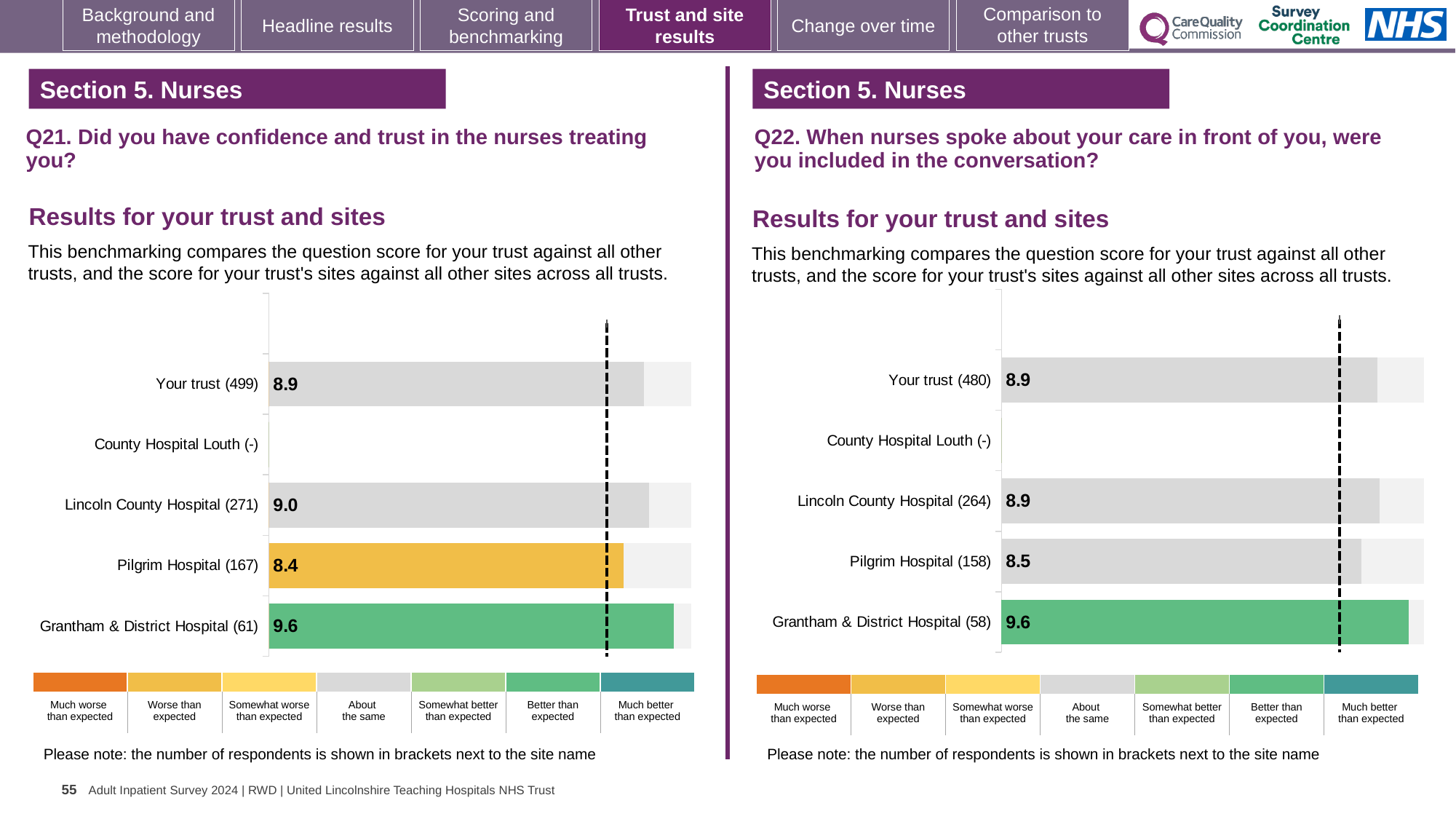
How many sites or categories are listed on the y axis of the Q22 chart on the right? 5 In the Q22 chart on the right, what is the score for Lincoln County Hospital (264)? 8.9 In the Q21 chart on the left, what is the difference between the scores for Grantham & District Hospital (61) and Pilgrim Hospital (167)? 1.2 In the Q22 chart on the right, what is the score for Grantham & District Hospital (58)? 9.6 In the Q21 chart on the left, what is the score for Your trust (499)? 8.9 In the Q21 chart on the left, which has the higher score: Lincoln County Hospital (271) or Your trust (499)? Lincoln County Hospital (271) What type of chart is the Q21 chart on the left? Bar chart In the Q22 chart on the right, what is the difference between the scores for Your trust (480) and Pilgrim Hospital (158)? 0.4 In the Q21 chart on the left, what is the score for Pilgrim Hospital (167)? 8.4 In the Q21 chart on the left, which site with a plotted score has the lowest score? Pilgrim Hospital (167) In the Q22 chart on the right, which site with a plotted score has the lowest score? Pilgrim Hospital (158) In the Q21 chart on the left, which site has the highest score? Grantham & District Hospital (61)